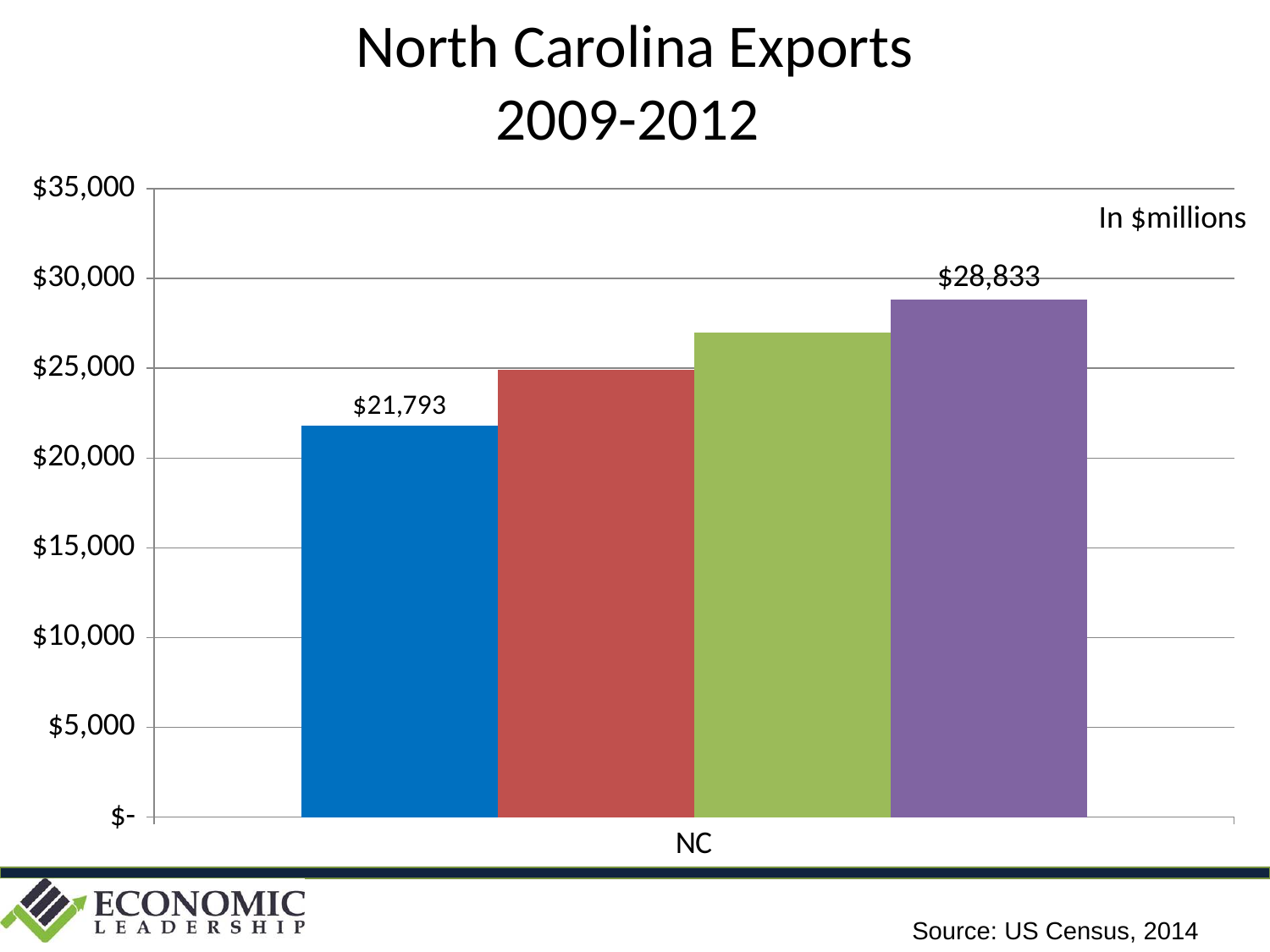
Is the value for the green bar greater or less than $25,000? greater Do the bar values rise or fall from left to right? Rise Which is larger, the red bar or the green bar? The green bar What unit note is shown in the top right of the chart? In $millions Which bar is the shortest? The leftmost (blue) bar What is the value shown on the leftmost (blue) bar? $21,793 Is the value for the red bar greater or less than $20,000? greater What is the value shown on the rightmost (purple) bar? $28,833 Which bar is the tallest? The rightmost (purple) bar What kind of chart is shown on the slide? Bar chart How many bars are plotted in the chart? 4 What is the difference between the rightmost bar ($28,833) and the leftmost bar ($21,793)? $7,040